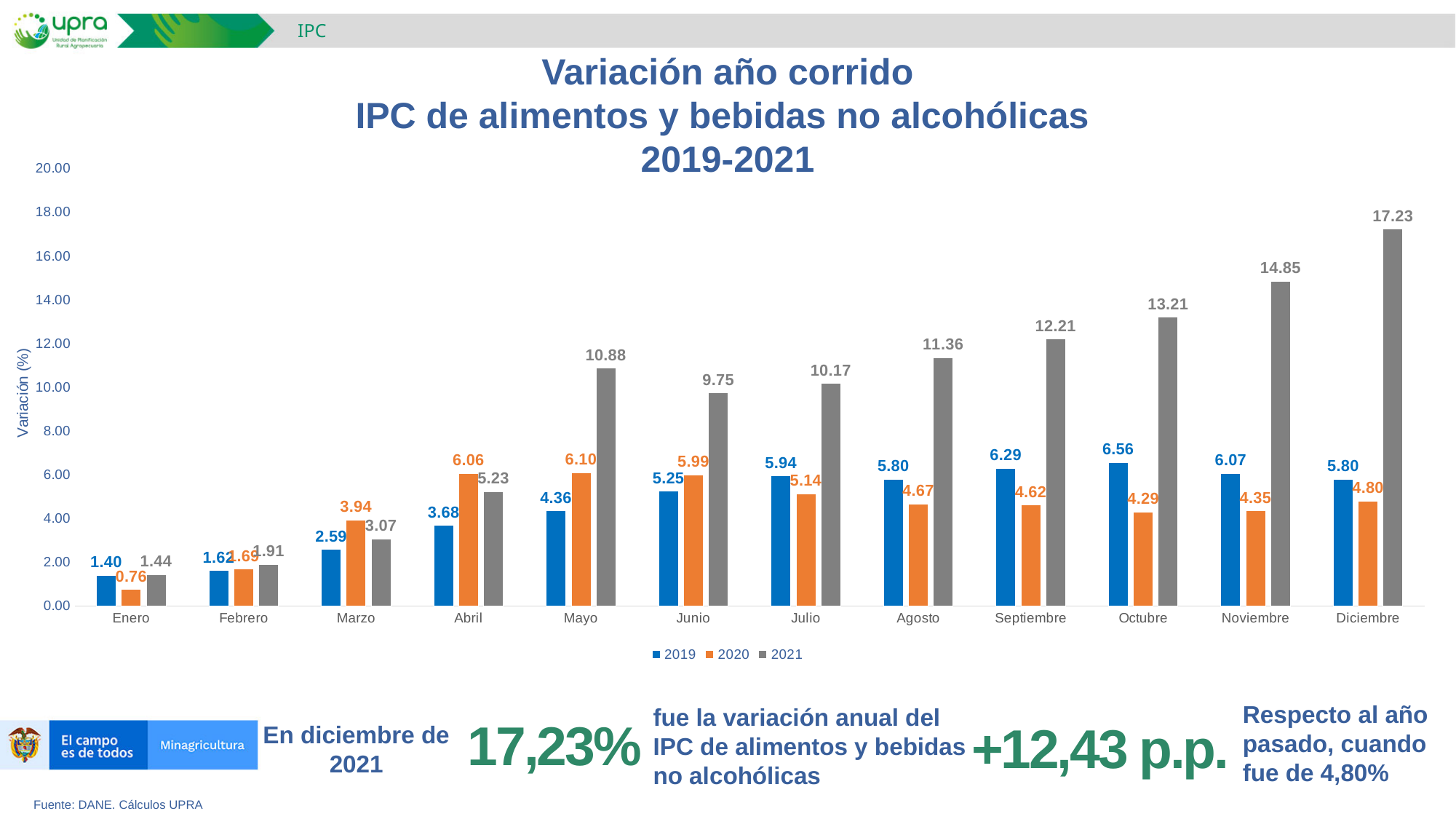
Does the 2021 series rise or fall from Mayo to Diciembre? rise In which month does the 2020 series have its lowest value? Enero What is the value for 2021 in Diciembre? 17.23 In Marzo, which series has the larger value, 2020 or 2021? 2020 What kind of chart is shown on the slide? bar chart How many months are shown on the x axis? 12 In which month does the 2021 series reach its highest value? Diciembre What is the value for 2020 in Abril? 6.06 Is the value for 2021 in Noviembre greater or less than 14.00? greater What is the difference between the 2021 and 2020 values in Diciembre? 12.43 How many series does the legend list? 3 What is the value for 2019 in Octubre? 6.56